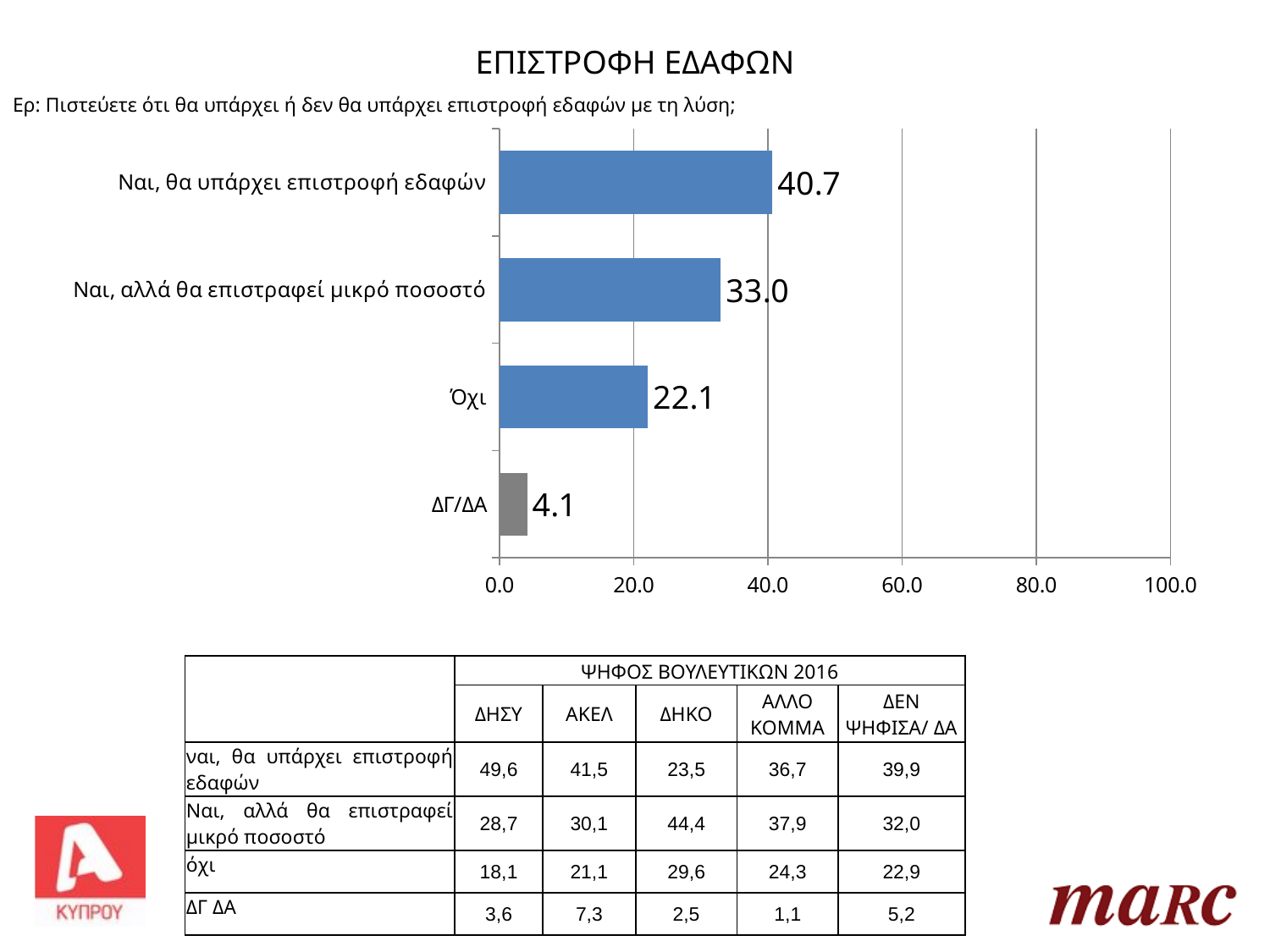
Which is larger: the value for "Ναι, αλλά θα επιστραφεί μικρό ποσοστό" or the value for "Όχι"? Ναι, αλλά θα επιστραφεί μικρό ποσοστό What is the value for "Ναι, θα υπάρχει επιστροφή εδαφών"? 40.7 What is the difference between the values for "Ναι, θα υπάρχει επιστροφή εδαφών" and "Όχι"? 18.6 How many categories are shown in the chart? 4 What is the value for "ΔΓ/ΔΑ"? 4.1 What is the value for "Όχι"? 22.1 Which category has the lowest value? ΔΓ/ΔΑ Which category has the highest value? Ναι, θα υπάρχει επιστροφή εδαφών What kind of chart is shown on the slide? bar chart What is the title of the chart? ΕΠΙΣΤΡΟΦΗ ΕΔΑΦΩΝ What is the value for "Ναι, αλλά θα επιστραφεί μικρό ποσοστό"? 33.0 Is the value for "Ναι, θα υπάρχει επιστροφή εδαφών" greater or less than 40.0? greater